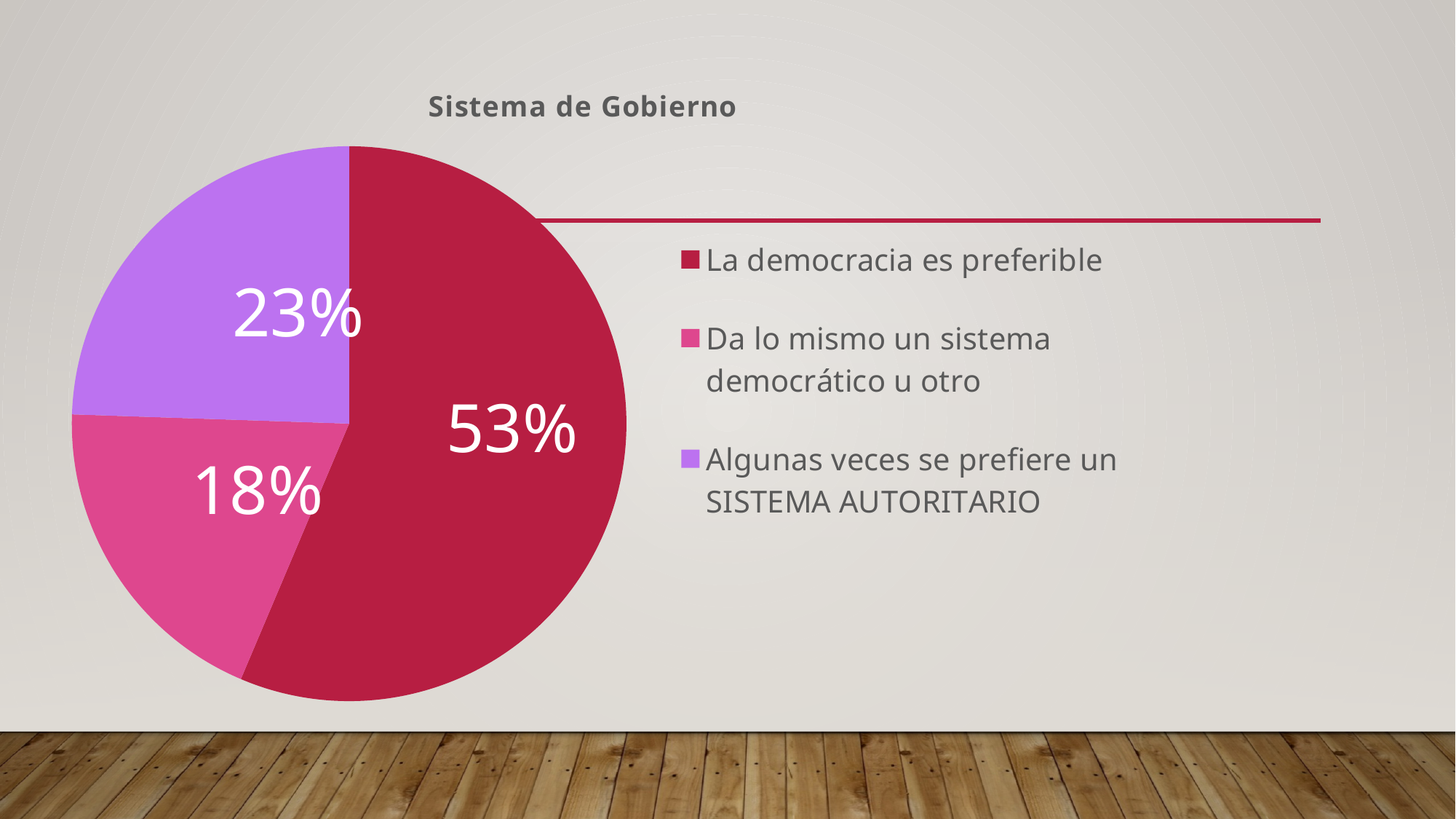
Which is larger: the slice for "Da lo mismo un sistema democrático u otro" or the slice for "Algunas veces se prefiere un SISTEMA AUTORITARIO"? Algunas veces se prefiere un SISTEMA AUTORITARIO What kind of chart is shown on the slide? pie chart Which category has the largest slice of the pie? La democracia es preferible What colour is the slice for "Algunas veces se prefiere un SISTEMA AUTORITARIO"? purple What percentage is shown for "Algunas veces se prefiere un SISTEMA AUTORITARIO"? 23% What percentage is shown for "La democracia es preferible"? 53% What percentage is shown for "Da lo mismo un sistema democrático u otro"? 18% What is the title of the chart? Sistema de Gobierno What is the difference in percentage points between "Algunas veces se prefiere un SISTEMA AUTORITARIO" and "Da lo mismo un sistema democrático u otro"? 5 How many slices does the pie chart have? 3 Which category has the smallest slice of the pie? Da lo mismo un sistema democrático u otro What is the difference in percentage points between "La democracia es preferible" and "Algunas veces se prefiere un SISTEMA AUTORITARIO"? 30